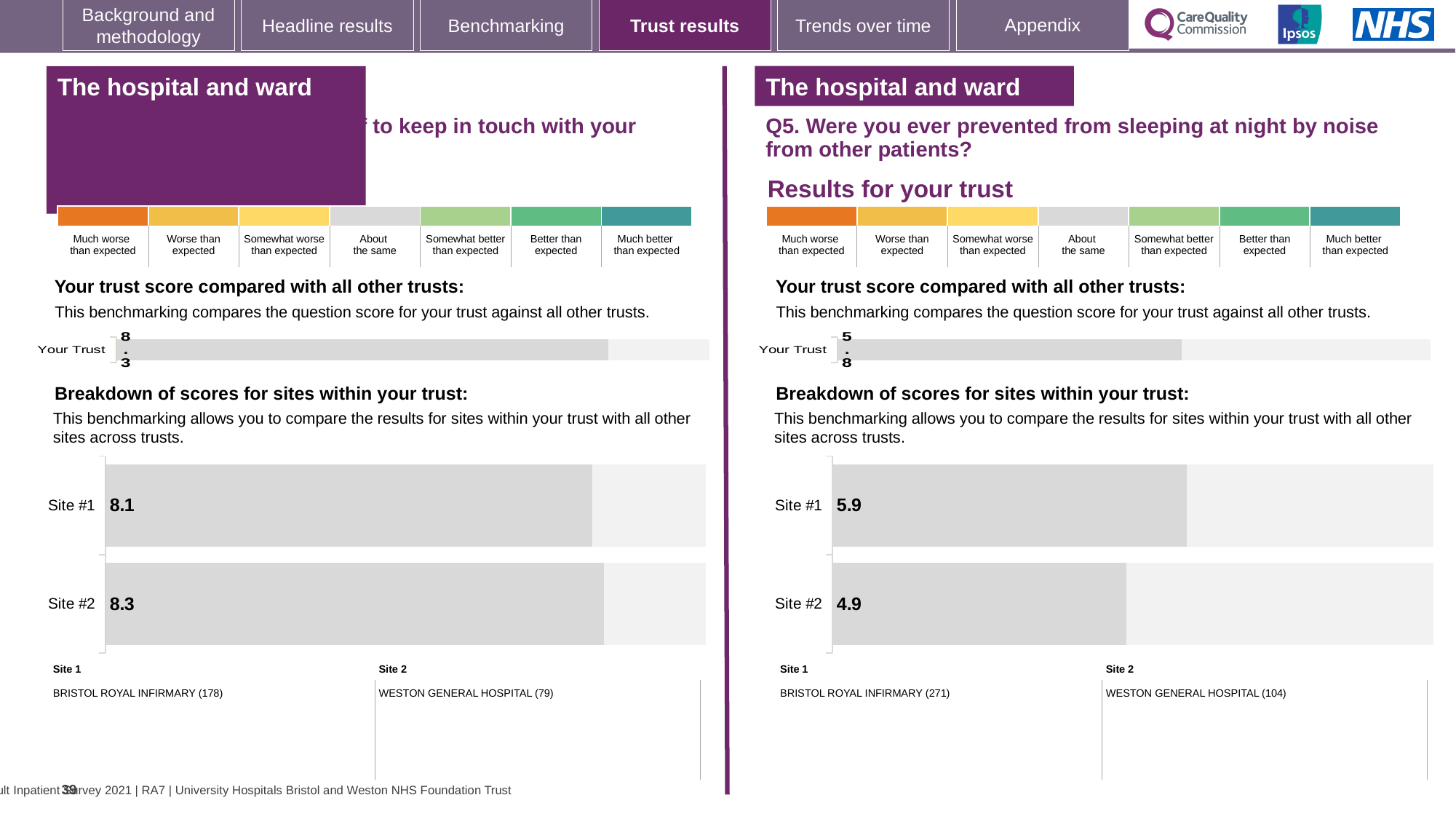
On the left-hand site breakdown chart, what is the score for Site #2? 8.3 On the right-hand chart for Q5, what is the score for Site #2? 4.9 What type of chart is used for the site breakdown on the right-hand side for Q5? Bar chart On the right-hand 'Your trust score compared with all other trusts' chart for Q5, what is the Your Trust score? 5.8 On the left-hand site breakdown chart, which site has the lower score? Site #1 On the right-hand site breakdown chart for Q5, which site has the higher score? Site #1 On the left-hand 'Your trust score compared with all other trusts' chart, what is the Your Trust score? 8.3 On the right-hand site breakdown chart for Q5, what is the difference between the Site #1 and Site #2 scores? 1.0 On the left-hand site breakdown chart, what is the score for Site #1? 8.1 How many sites are shown in the right-hand site breakdown chart for Q5? 2 On the right-hand chart for Q5 (prevented from sleeping at night by noise from other patients), what is the score for Site #1? 5.9 On the left-hand site breakdown chart, what is the difference between the Site #2 and Site #1 scores? 0.2